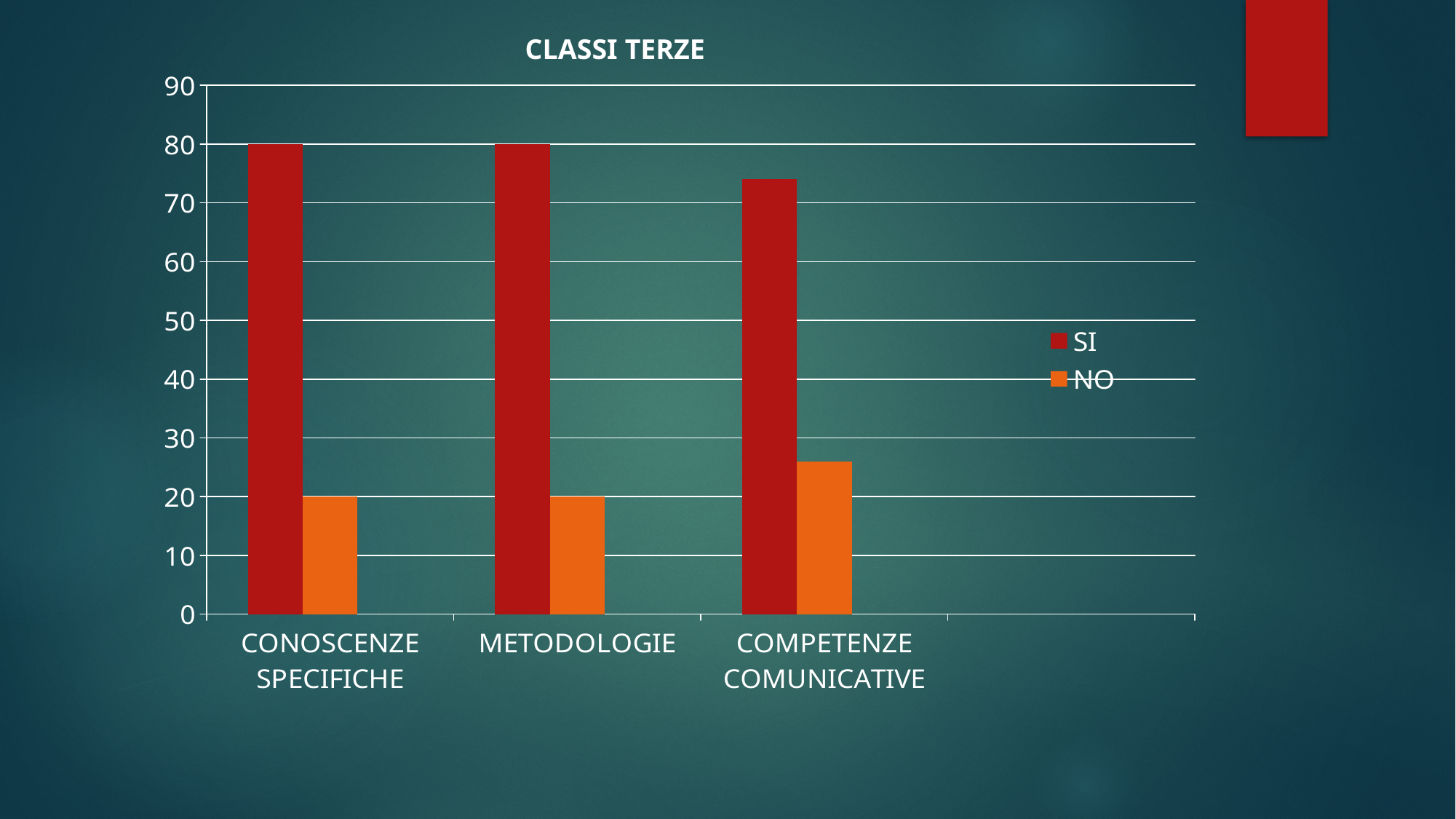
Which category has the highest NO value? COMPETENZE COMUNICATIVE How many categories are shown on the x axis? 3 How many series does the legend list? 2 Which category has the lowest SI value? COMPETENZE COMUNICATIVE What kind of chart is shown on the slide? bar chart For METODOLOGIE, which is larger, SI or NO? SI What is the difference between the SI and NO values for CONOSCENZE SPECIFICHE? 60 What is the NO value for METODOLOGIE? 20 Is the NO value for COMPETENZE COMUNICATIVE greater or less than 30? less Is the SI value for COMPETENZE COMUNICATIVE greater or less than 70? greater What is the SI value for CONOSCENZE SPECIFICHE? 80 What is the title of the chart? CLASSI TERZE